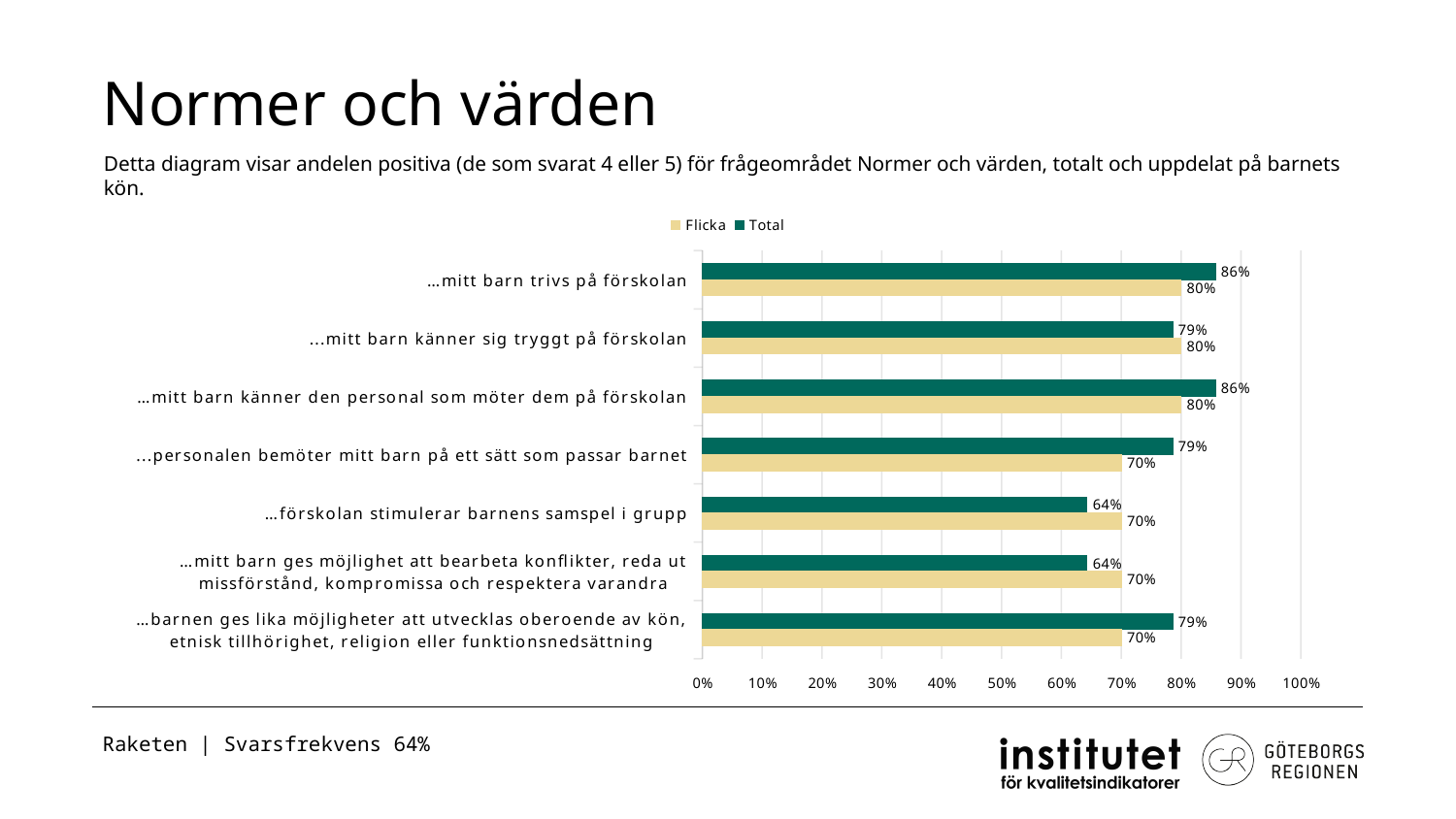
How many series does the legend list? 2 What is the Total value for "…barnen ges lika möjligheter att utvecklas oberoende av kön, etnisk tillhörighet, religion eller funktionsnedsättning"? 79% What is the Flicka value for "...personalen bemöter mitt barn på ett sätt som passar barnet"? 70% What is the Total value for "…mitt barn trivs på förskolan"? 86% What is the Flicka value for "…mitt barn trivs på förskolan"? 80% How many categories are shown on the chart? 7 What is the difference between the Total and Flicka values for "...personalen bemöter mitt barn på ett sätt som passar barnet"? 9% What is the Total value for "…förskolan stimulerar barnens samspel i grupp"? 64% For "…förskolan stimulerar barnens samspel i grupp", which series has the higher value, Flicka or Total? Flicka What kind of chart is shown on the slide? Bar chart For "…mitt barn känner den personal som möter dem på förskolan", which series has the higher value, Flicka or Total? Total What is the difference between the Total and Flicka values for "…mitt barn trivs på förskolan"? 6%